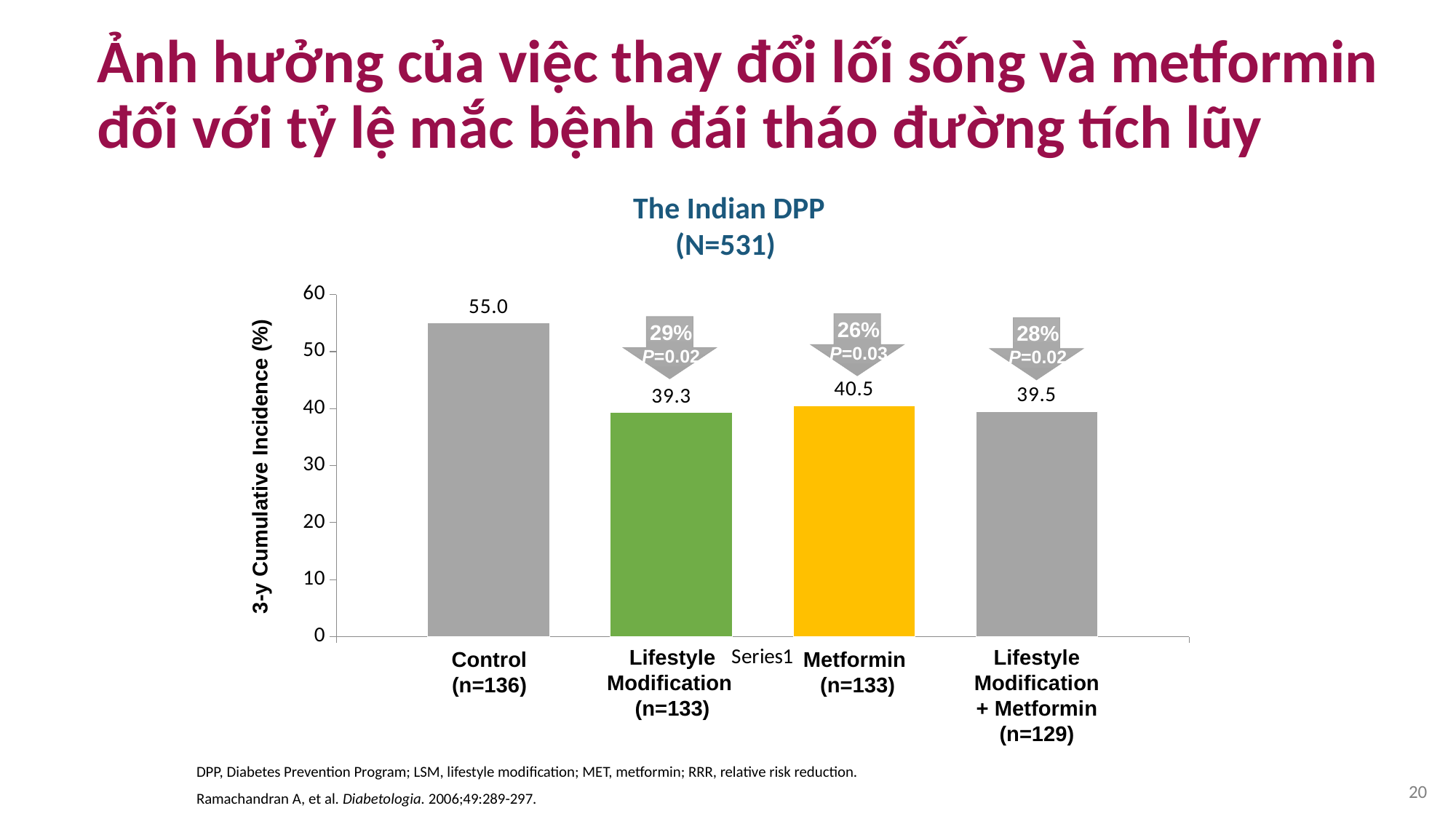
What is the difference in 3-y cumulative incidence between the Control group and the Metformin group? 14.5 Which group has the highest 3-y cumulative incidence? Control What is the 3-y cumulative incidence for the Metformin group? 40.5 Is the value for the Control group greater or less than 50? greater What kind of chart is shown on the slide? Bar chart How many groups are shown on the chart? 4 Which has a higher 3-y cumulative incidence, the Metformin group or the Lifestyle Modification group? Metformin What is the label of the y axis of the chart? 3-y Cumulative Incidence (%) What is the 3-y cumulative incidence for the Lifestyle Modification + Metformin group? 39.5 What is the 3-y cumulative incidence for the Lifestyle Modification group? 39.3 What is the 3-y cumulative incidence for the Control group? 55.0 What is the difference in 3-y cumulative incidence between the Control group and the Lifestyle Modification group? 15.7